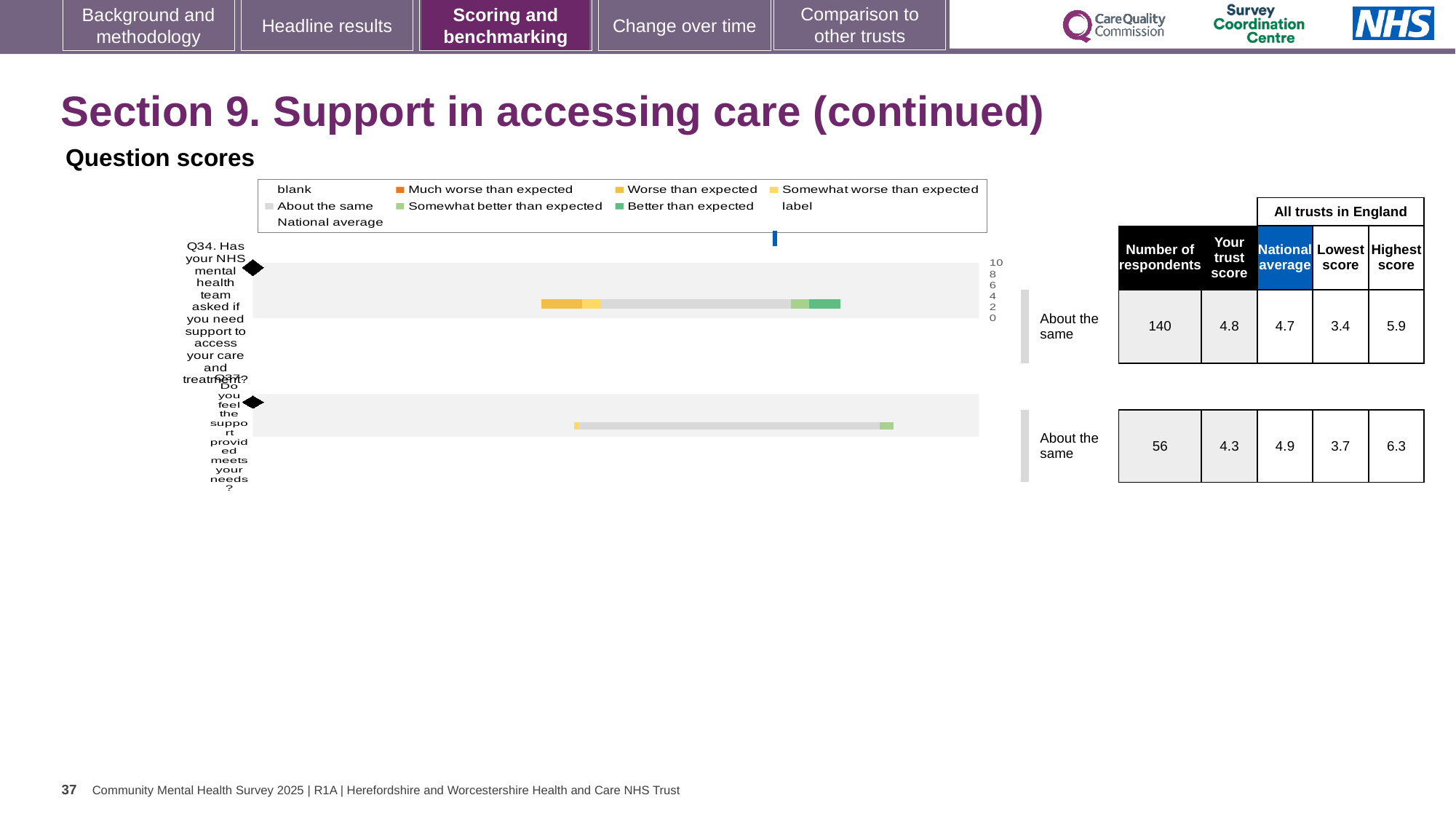
What is the difference between the highest score and the lowest score for Q37? 2.6 What kind of chart is used to show the question scores on this slide? bar chart What benchmark category is shown for Q37 in the question scores chart? About the same For Q37, which is larger: the trust score or the national average? the national average Which question has the higher number of respondents, Q34 or Q37? Q34 What is the difference between the highest score and the lowest score for Q34? 2.5 For Q34, which is larger: the trust score or the national average? the trust score How many respondents answered Q34? 140 What is the maximum value shown on the score axis of the question scores chart? 10 What is the national average score for Q37 (Do you feel the support provided meets your needs)? 4.9 What is the trust score for Q34 (Has your NHS mental health team asked if you need support to access your care and treatment)? 4.8 How many questions are plotted in the question scores chart? 2